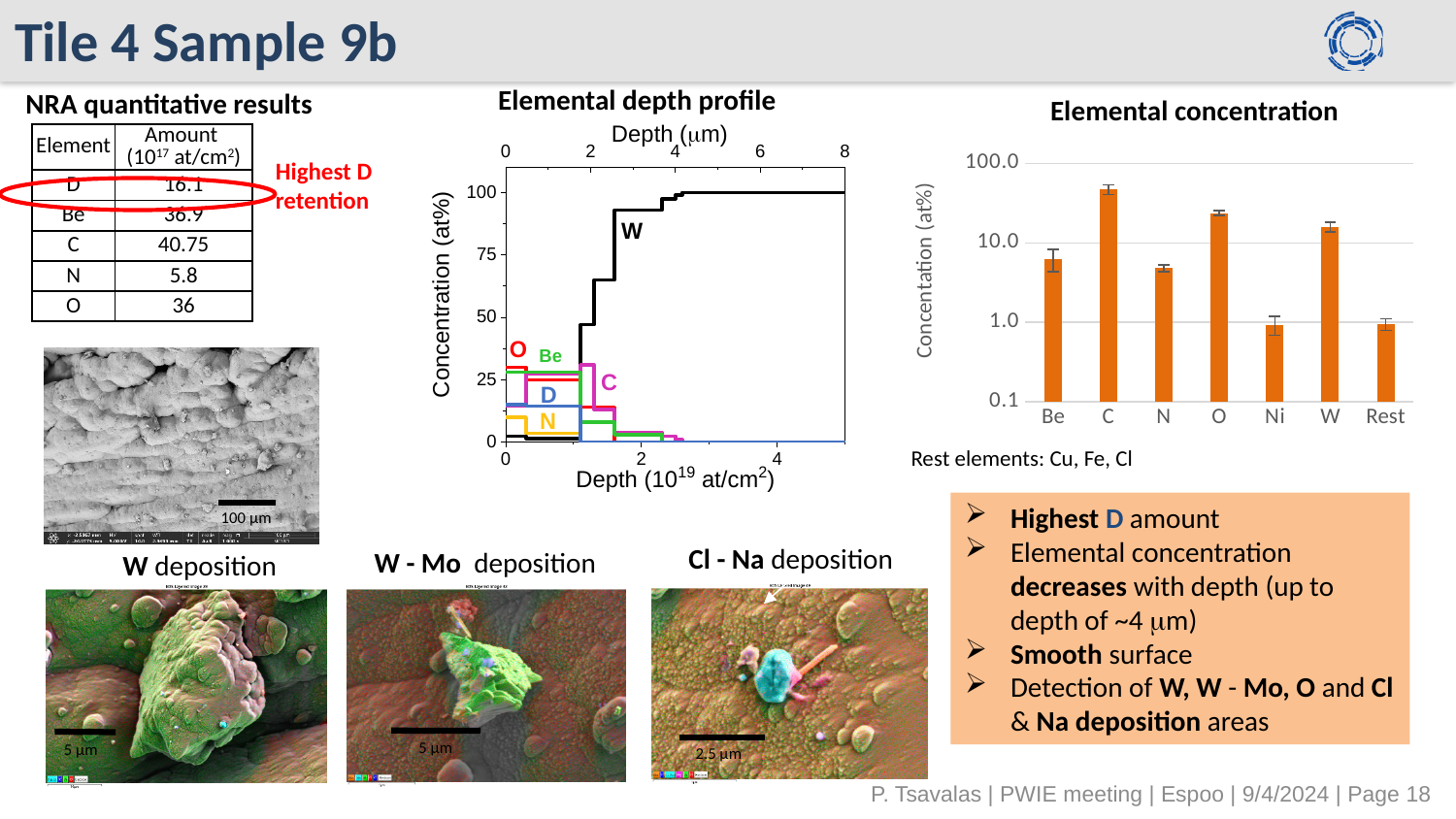
In the Elemental concentration chart, how many categories are shown on the x axis? 7 In the Elemental concentration chart, is the value for Be greater or less than 10.0? less In the Elemental concentration chart, is the value for N greater or less than 10.0? less In the Elemental concentration chart, which is larger, the value for C or the value for W? C In the Elemental concentration chart, is the value for O greater or less than 10.0? greater In the Elemental depth profile chart, which element's concentration rises with depth? W What is the y-axis label of the Elemental concentration chart? Concentration (at%) What kind of chart is the Elemental concentration chart? bar chart In the Elemental concentration chart, which is larger, the value for O or the value for N? O In the Elemental depth profile chart, how many elements are labelled on the plotted lines? 6 In the Elemental concentration chart, which element has the highest concentration? C